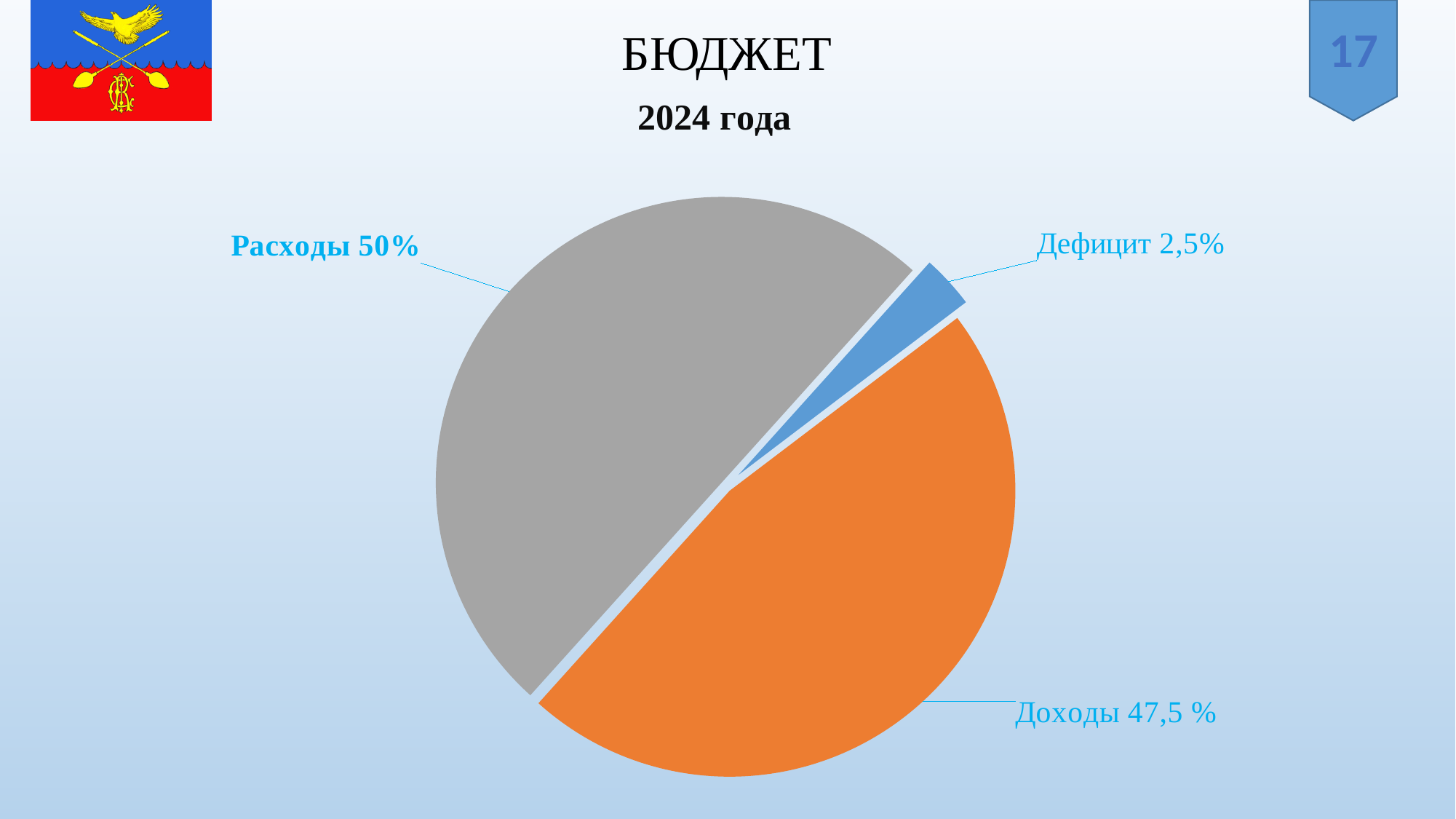
What is the difference between the values for Доходы and Дефицит? 45% Which is larger, Расходы or Доходы? Расходы How many slices does the pie chart have? 3 Which slice of the pie is the smallest? Дефицит What is the difference between the values for Расходы and Доходы? 2,5% What is the value shown for Доходы? 47,5 % What is the value shown for Дефицит? 2,5% What kind of chart is shown on the slide? pie chart What is the value shown for Расходы? 50% What is the title of the chart? 2024 года Which slice of the pie is the largest? Расходы What colour is the Доходы slice? orange